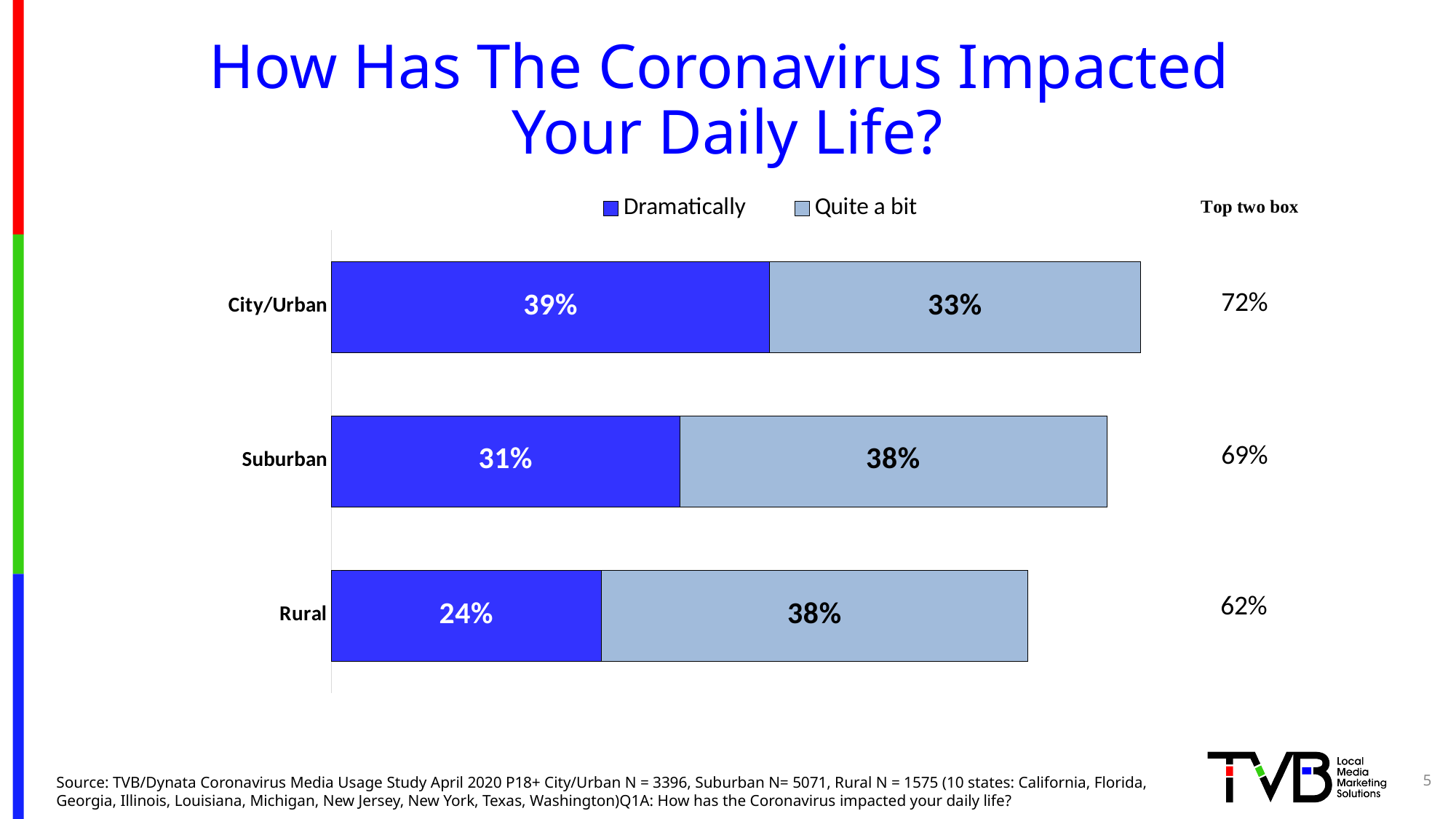
What is the total of the stacked bar for Rural (Dramatically plus Quite a bit)? 62% What is the difference between the Dramatically values for City/Urban and Rural? 15 percentage points What kind of chart is shown on the slide? Stacked bar chart How many categories are shown on the chart? 3 What percentage of City/Urban respondents said the Coronavirus impacted their daily life Dramatically? 39% Which is larger: the Quite a bit value for City/Urban or for Suburban? Suburban How many series does the legend list? 2 Which category has the highest Dramatically value? City/Urban What is the Top two box value shown for Suburban? 69% What is the Dramatically value for Rural respondents? 24% Which category has the lowest Dramatically value? Rural What is the Quite a bit value for Suburban respondents? 38%